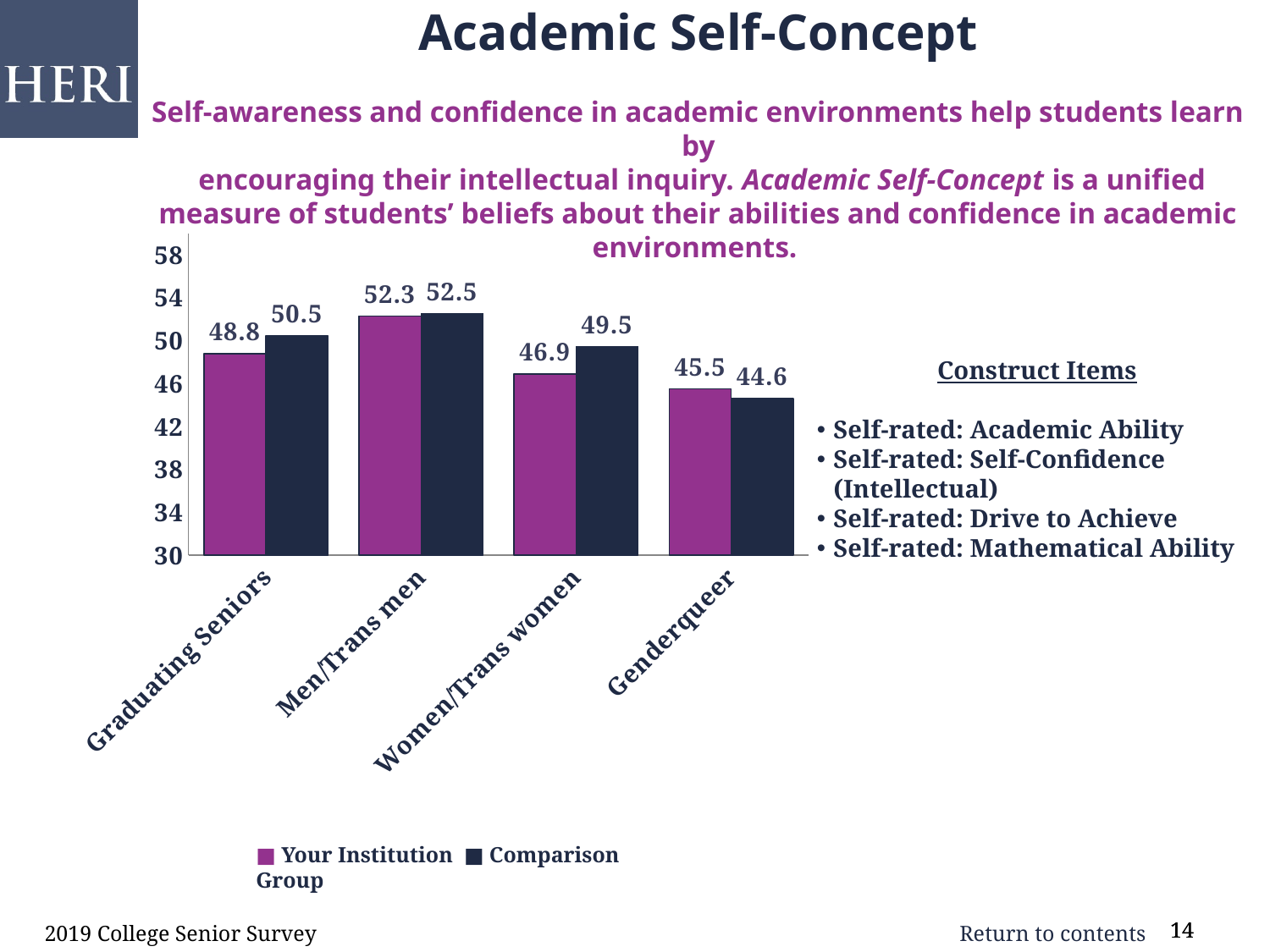
For Genderqueer, which is larger: Your Institution or Comparison Group? Your Institution What is the Comparison Group value for Genderqueer? 44.6 How many series does the legend list? 2 What kind of chart is shown? bar chart Which category has the highest Your Institution value? Men/Trans men How many categories are shown on the x axis? 4 Is the Your Institution value for Men/Trans men greater or less than 50? greater What is the Your Institution value for Graduating Seniors? 48.8 What are the two series named in the legend? Your Institution and Comparison Group What is the difference between the Comparison Group and Your Institution values for Women/Trans women? 2.6 What is the Comparison Group value for Women/Trans women? 49.5 Which category has the lowest Comparison Group value? Genderqueer